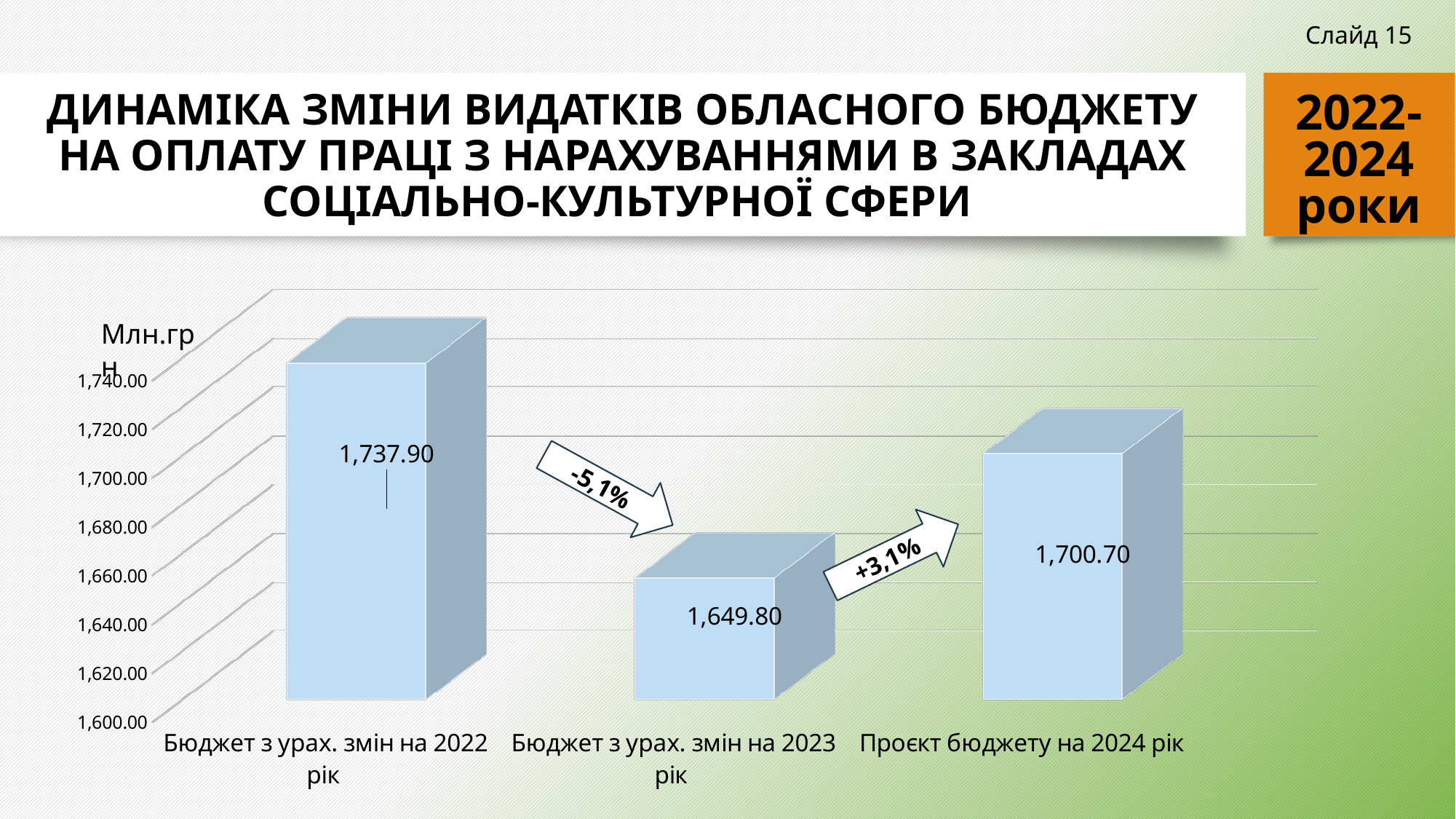
What is the value for "Проєкт бюджету на 2024 рік"? 1,700.70 What unit is indicated on the vertical axis of the chart? Млн.грн What percentage change is shown on the arrow between the 2023 and 2024 bars? +3,1% What is the difference between the values for 2022 and 2023? 88.10 What type of chart is shown on the slide? bar chart Which category has the highest value? Бюджет з урах. змін на 2022 рік What is the difference between the values for 2024 and 2023? 50.90 Which is larger: the value for 2022 or the value for 2024? 2022 How many bars are plotted in the chart? 3 What is the value for "Бюджет з урах. змін на 2022 рік"? 1,737.90 What is the value for "Бюджет з урах. змін на 2023 рік"? 1,649.80 Which category has the lowest value? Бюджет з урах. змін на 2023 рік